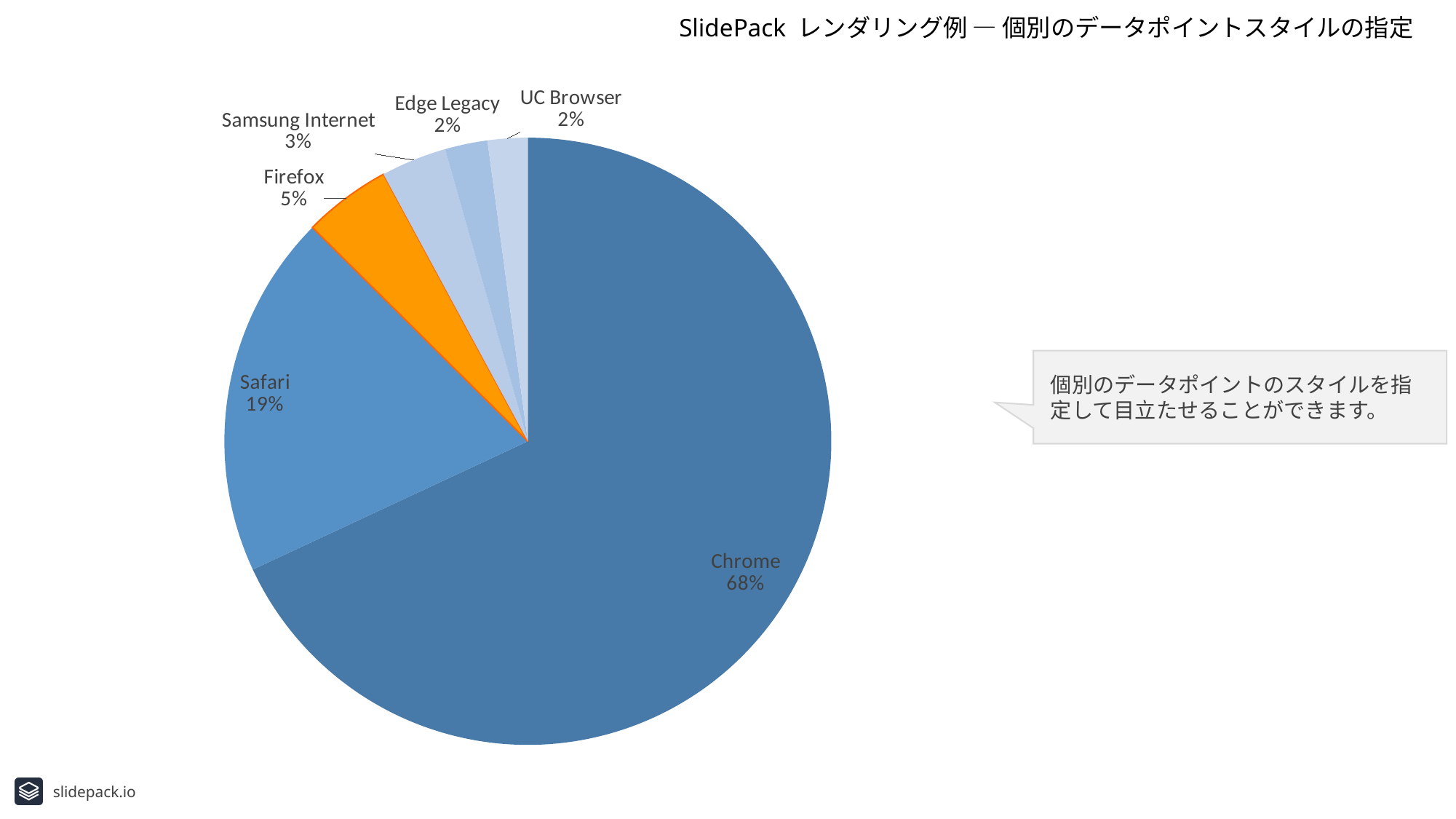
What is the value shown for Firefox? 5% How many categories are shown in the pie chart? 6 Which is larger, the Firefox slice or the Samsung Internet slice? Firefox Which category has the largest slice of the pie? Chrome What is the difference between the Chrome and Safari shares? 49% What share of the pie does Chrome have? 68% What is the value shown for Samsung Internet? 3% What is the value shown for Safari? 19% What is the difference between the Safari and Firefox shares? 14% Which slice of the pie is coloured orange? Firefox What value is shown for Edge Legacy? 2% What kind of chart is shown on the slide? Pie chart